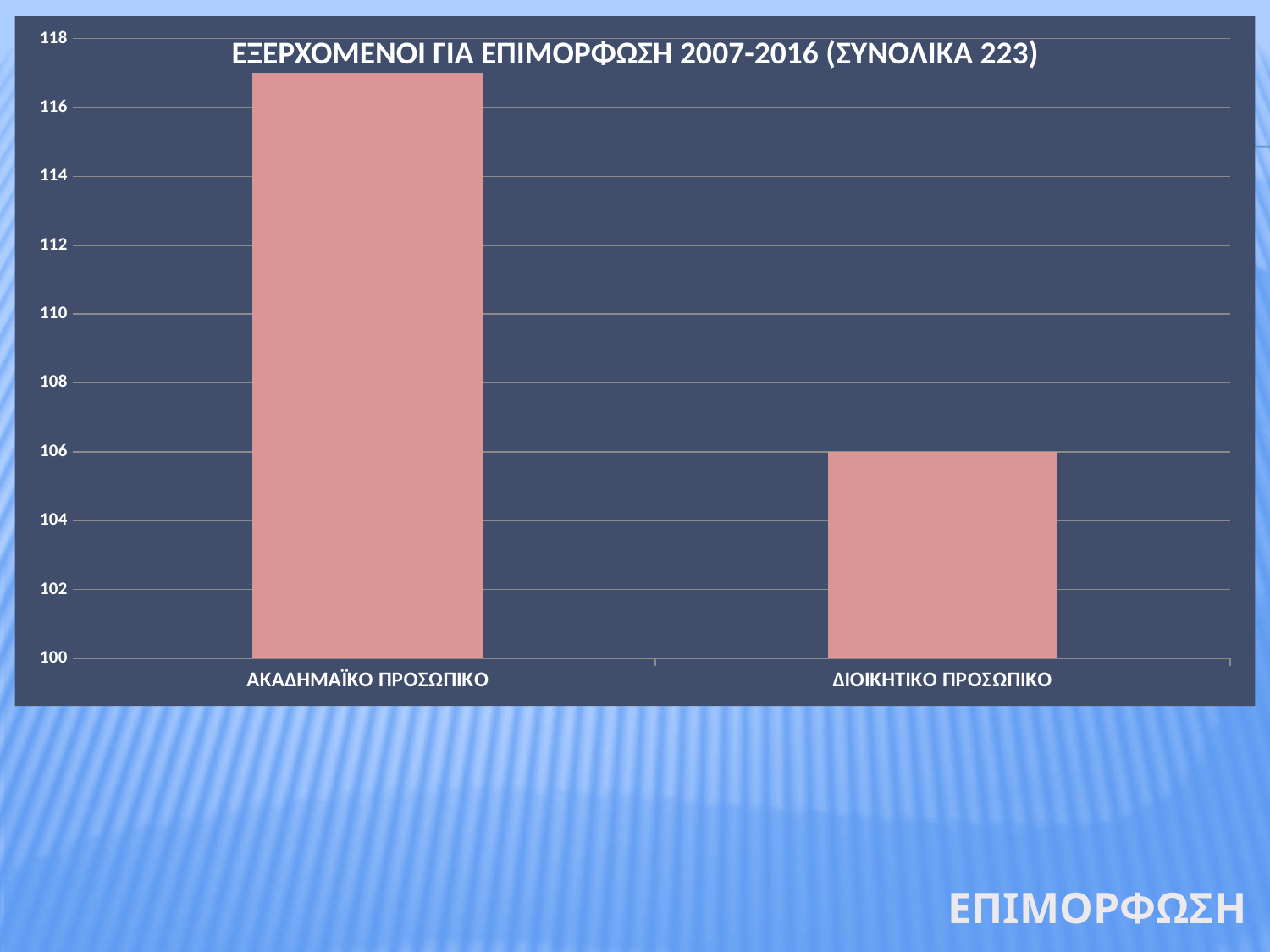
What is the title of the chart? ΕΞΕΡΧΟΜΕΝΟΙ ΓΙΑ ΕΠΙΜΟΡΦΩΣΗ 2007-2016 (ΣΥΝΟΛΙΚΑ 223) Is the value for ΑΚΑΔΗΜΑΪΚΟ ΠΡΟΣΩΠΙΚΟ greater or less than 116? greater Is the value for ΔΙΟΙΚΗΤΙΚΟ ΠΡΟΣΩΠΙΚΟ greater or less than 110? less Which category has the lowest value? ΔΙΟΙΚΗΤΙΚΟ ΠΡΟΣΩΠΙΚΟ Which is larger, the value for ΑΚΑΔΗΜΑΪΚΟ ΠΡΟΣΩΠΙΚΟ or the value for ΔΙΟΙΚΗΤΙΚΟ ΠΡΟΣΩΠΙΚΟ? ΑΚΑΔΗΜΑΪΚΟ ΠΡΟΣΩΠΙΚΟ Is the value for ΑΚΑΔΗΜΑΪΚΟ ΠΡΟΣΩΠΙΚΟ greater or less than 118? less What total number is stated in the chart title? 223 How many categories are plotted in the chart? 2 What is the value for ΔΙΟΙΚΗΤΙΚΟ ΠΡΟΣΩΠΙΚΟ? 106 Which category has the highest value? ΑΚΑΔΗΜΑΪΚΟ ΠΡΟΣΩΠΙΚΟ What kind of chart is shown on the slide? bar chart